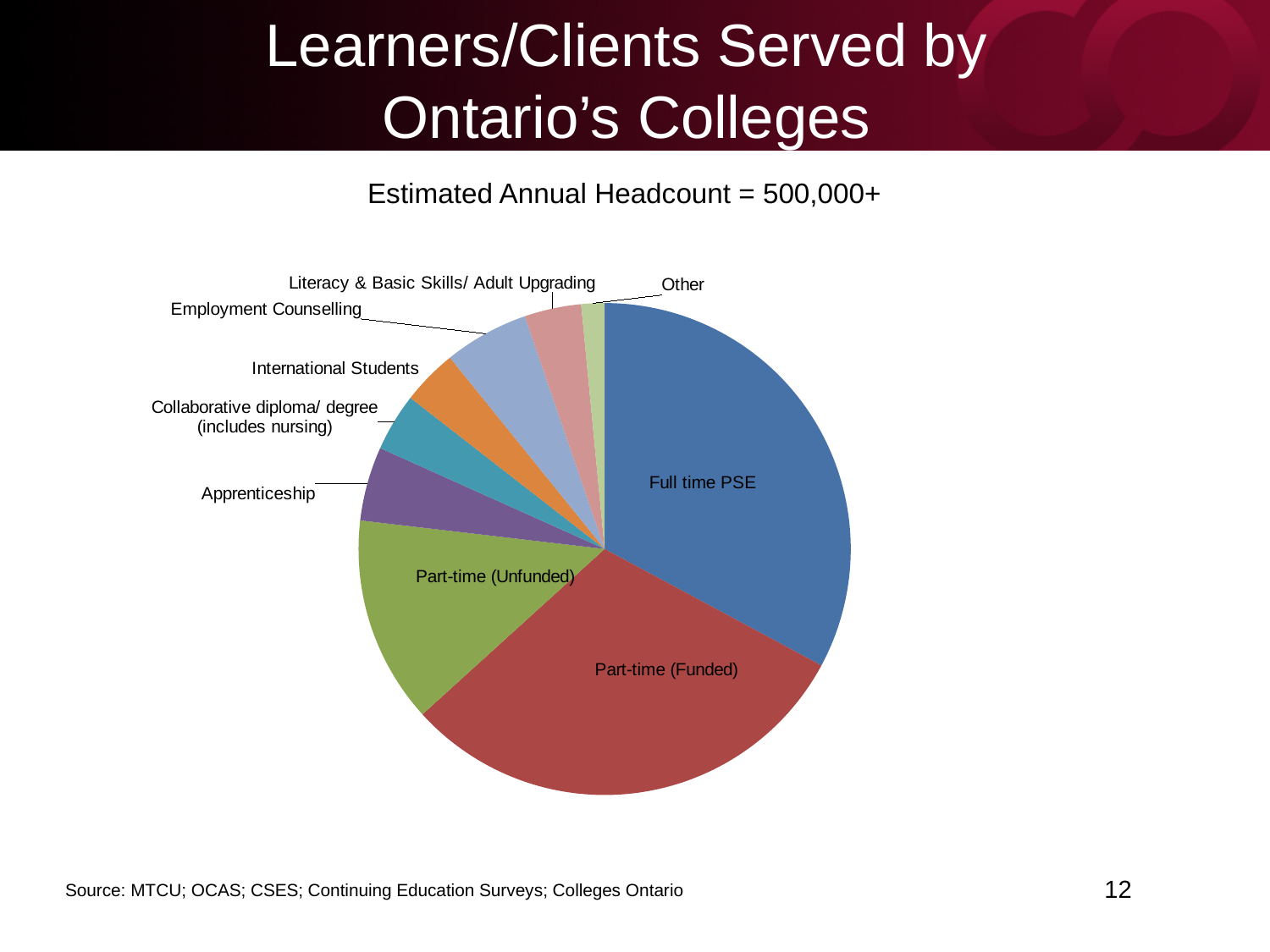
Which slice is larger: Part-time (Funded) or Apprenticeship? Part-time (Funded) What kind of chart is shown on the slide? Pie chart Which slice is larger: Employment Counselling or Collaborative diploma/ degree (includes nursing)? Employment Counselling Which category has the smallest slice of the pie chart? Other How many slices does the pie chart have? 9 Which slice is larger: Part-time (Unfunded) or International Students? Part-time (Unfunded) What estimated annual headcount is stated above the pie chart? 500,000+ What colour is the Part-time (Funded) slice? Red Which category has the largest slice of the pie chart? Full time PSE